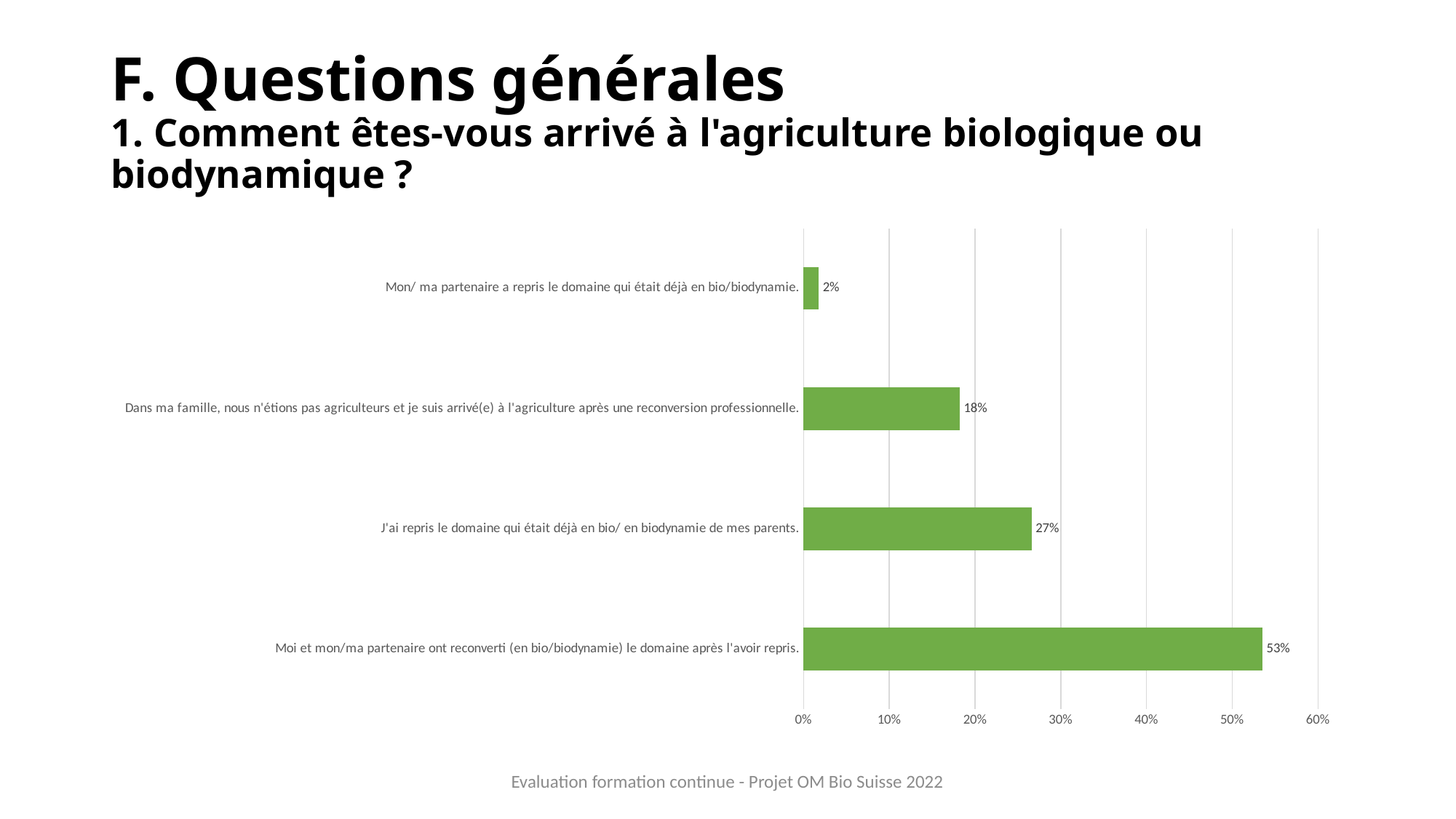
Is the value for 'Moi et mon/ma partenaire ont reconverti (en bio/biodynamie) le domaine après l'avoir repris.' greater or less than 50%? greater What percentage of respondents said 'Moi et mon/ma partenaire ont reconverti (en bio/biodynamie) le domaine après l'avoir repris.'? 53% Which is larger: the value for 'J'ai repris le domaine qui était déjà en bio/ en biodynamie de mes parents.' or the value for 'Dans ma famille, nous n'étions pas agriculteurs et je suis arrivé(e) à l'agriculture après une reconversion professionnelle.'? J'ai repris le domaine qui était déjà en bio/ en biodynamie de mes parents. What is the maximum value shown on the x axis of the chart? 60% Which category has the lowest value? Mon/ ma partenaire a repris le domaine qui était déjà en bio/biodynamie. What is the difference between the value for 'Moi et mon/ma partenaire ont reconverti (en bio/biodynamie) le domaine après l'avoir repris.' and the value for 'J'ai repris le domaine qui était déjà en bio/ en biodynamie de mes parents.'? 26% What is the value for 'Mon/ ma partenaire a repris le domaine qui était déjà en bio/biodynamie.'? 2% How many categories are shown in the chart? 4 What is the value for 'Dans ma famille, nous n'étions pas agriculteurs et je suis arrivé(e) à l'agriculture après une reconversion professionnelle.'? 18% Which category has the highest value? Moi et mon/ma partenaire ont reconverti (en bio/biodynamie) le domaine après l'avoir repris. What is the value for 'J'ai repris le domaine qui était déjà en bio/ en biodynamie de mes parents.'? 27% What kind of chart is shown on the slide? bar chart